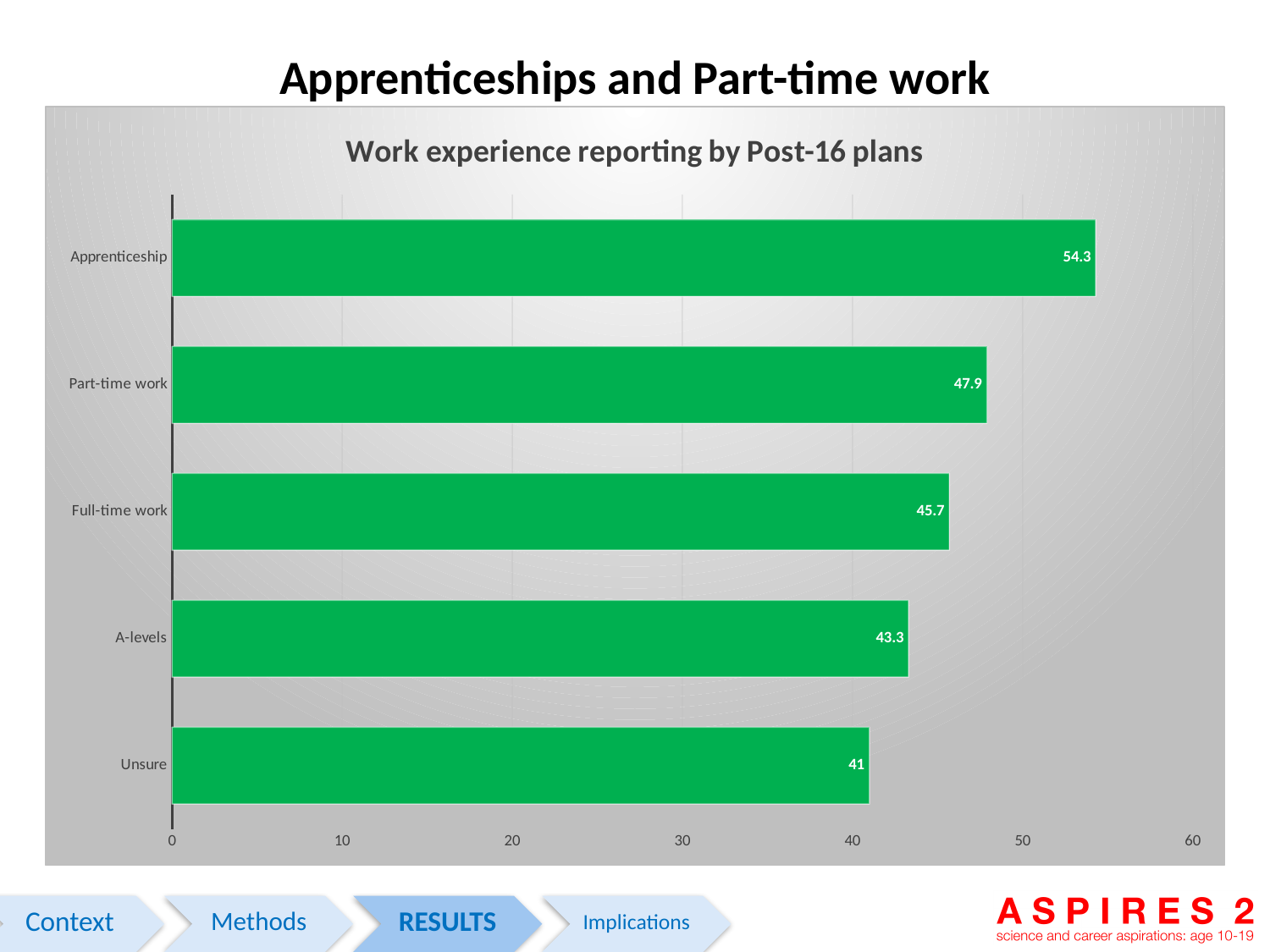
Which is larger, the value for Full-time work or the value for A-levels? Full-time work What is the difference between the values for Apprenticeship and Unsure? 13.3 What is the value for Apprenticeship? 54.3 Is the value for A-levels greater or less than 40? greater What is the value for Unsure? 41 Which category has the highest value? Apprenticeship What is the value for Part-time work? 47.9 How many categories are shown in the chart? 5 Which category has the lowest value? Unsure What is the title of the chart? Work experience reporting by Post-16 plans What is the difference between the values for Part-time work and Full-time work? 2.2 What kind of chart is shown on the slide? Bar chart